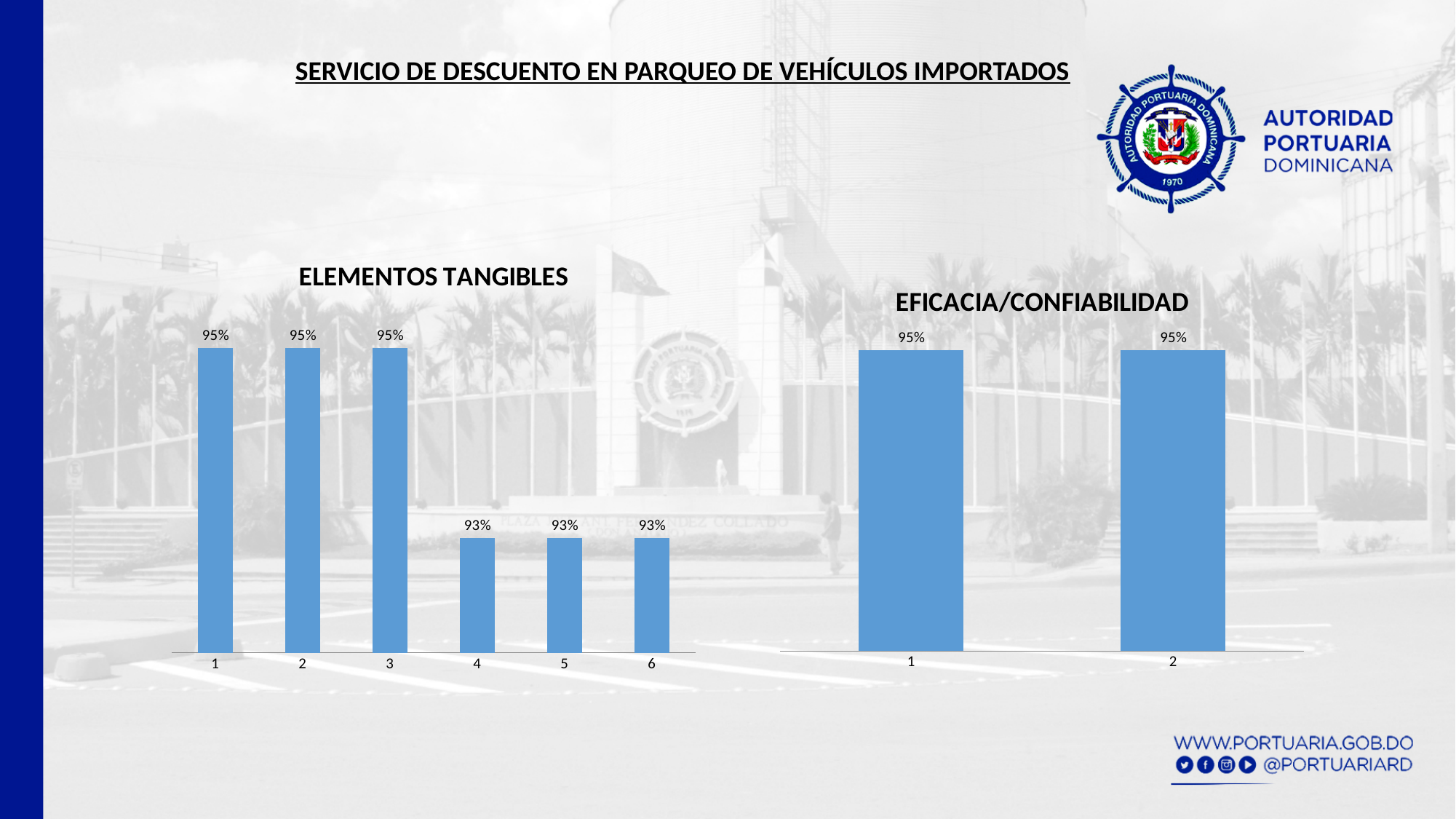
How many charts are shown on the slide? 2 In the ELEMENTOS TANGIBLES chart, what is the value for category 1? 95% What kind of chart is the ELEMENTOS TANGIBLES chart? Bar chart In the ELEMENTOS TANGIBLES chart, what is the difference between the value for category 3 and the value for category 4? 2% In the ELEMENTOS TANGIBLES chart, how many categories are shown on the x axis? 6 What is the title of the chart on the right side of the slide? EFICACIA/CONFIABILIDAD In the EFICACIA/CONFIABILIDAD chart, what is the value for category 2? 95% In the ELEMENTOS TANGIBLES chart, what is the value for category 6? 93% In the EFICACIA/CONFIABILIDAD chart, how many bars are plotted? 2 In the ELEMENTOS TANGIBLES chart, what is the value for category 4? 93% In the ELEMENTOS TANGIBLES chart, which is larger, the value for category 2 or the value for category 5? Category 2 In the ELEMENTOS TANGIBLES chart, do the values rise or fall from category 3 to category 4? Fall